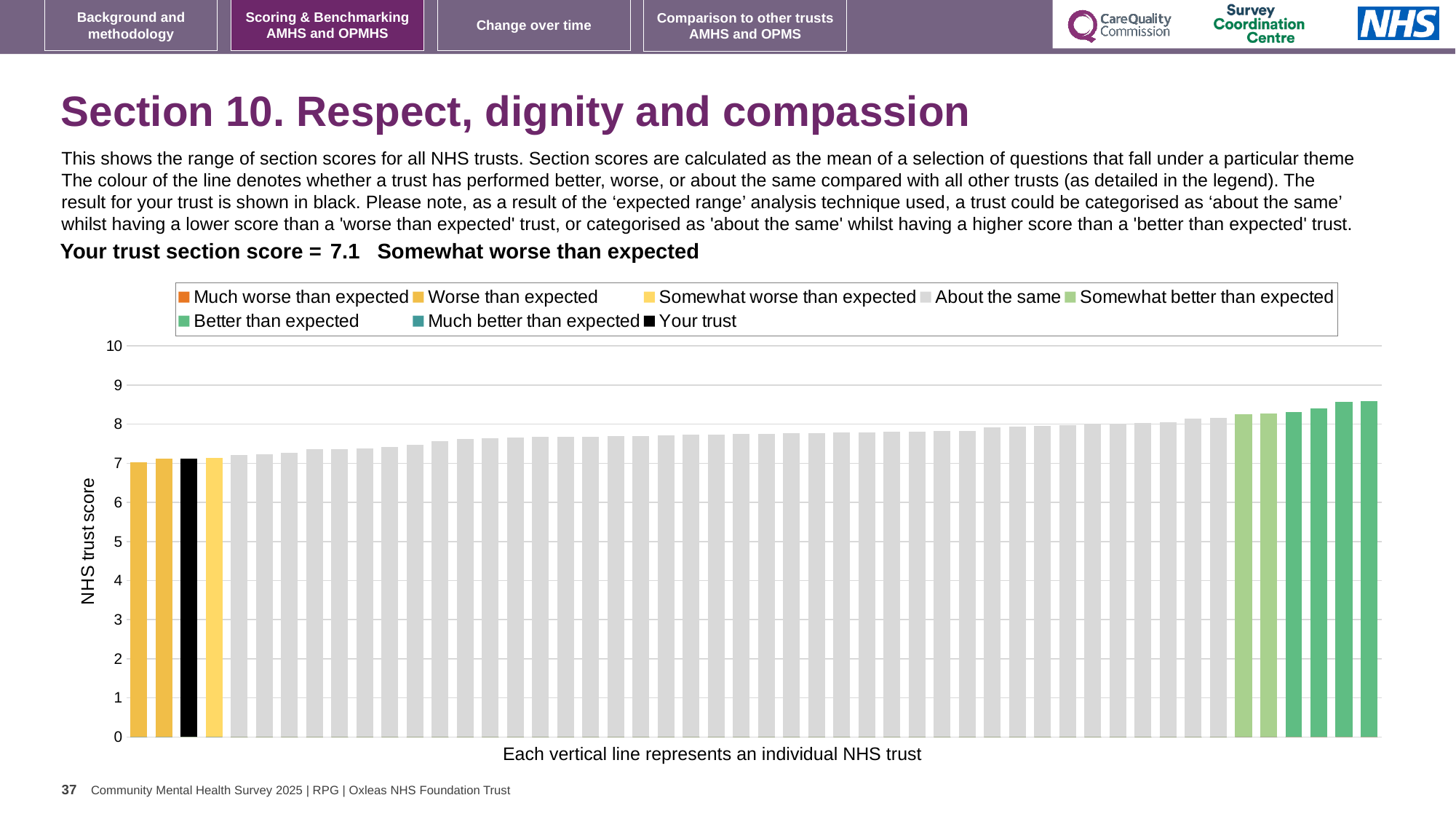
How many categories does the chart legend list? 8 What is the section score for your trust shown on the slide? 7.1 Is the shortest bar in the chart greater or less than 6? greater Do the bar values rise or fall from left to right along the x axis? rise Which legend category is your trust placed in for this section? Somewhat worse than expected Is the score for your trust (the black bar) greater or less than 8? less What is the label on the vertical axis of the chart? NHS trust score What kind of chart is shown on the slide? bar chart Which legend category do the tallest bars on the right of the chart belong to? Better than expected What colour is the bar representing your trust? black Is the tallest bar in the chart greater or less than 8? greater